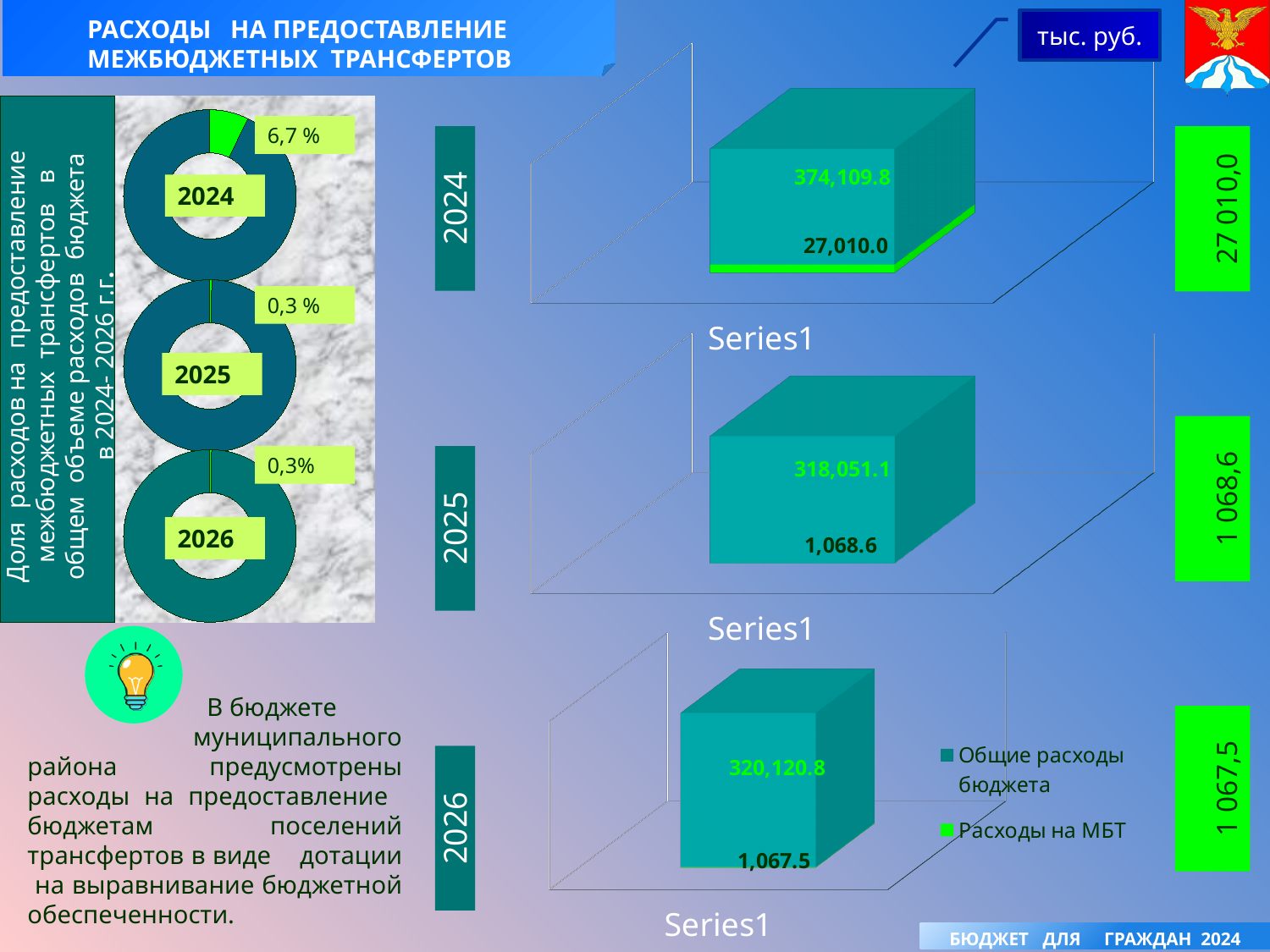
Across the three bar charts, which year has the highest value for expenses on intergovernmental transfers (МБТ)? 2024 How many series does the legend of the bar charts list? 2 In the 2025 bar chart, what is the value labelled for total budget expenses? 318,051.1 In the 2024 bar chart, which is larger: total budget expenses or expenses on МБТ? Total budget expenses In the 2026 bar chart, what is the value labelled for total budget expenses? 320,120.8 In the 2024 bar chart, what is the value labelled for total budget expenses (Общие расходы бюджета)? 374,109.8 In the 2024 bar chart, what is the value labelled for expenses on intergovernmental transfers (Расходы на МБТ)? 27,010.0 In the 2026 bar chart, what is the value labelled for expenses on intergovernmental transfers (МБТ)? 1,067.5 Across the three bar charts, which year has the lowest value for total budget expenses? 2025 In the 2025 bar chart, what is the value labelled for expenses on intergovernmental transfers (МБТ)? 1,068.6 In the 2024 donut chart on the left, what share of total budget expenses do intergovernmental transfer expenses make up? 6,7 % In the 2025 donut chart on the left, what share is shown for intergovernmental transfer expenses? 0,3 %